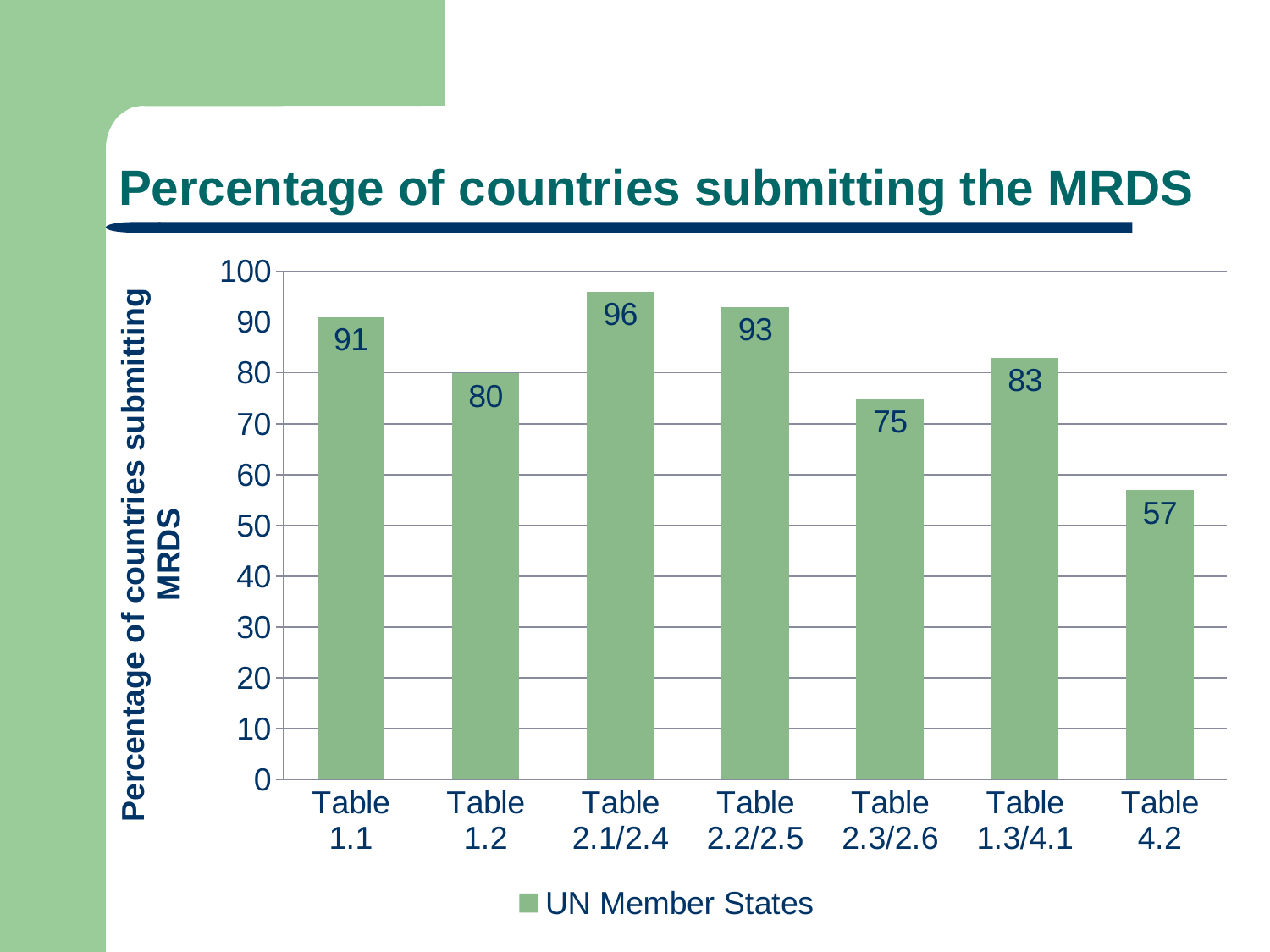
How many categories are shown on the x axis? 7 What is the difference between the values for Table 2.1/2.4 and Table 4.2? 39 Which category has the highest value? Table 2.1/2.4 What is the value for Table 1.1? 91 Which category has the lowest value? Table 4.2 Which is larger, the value for Table 2.2/2.5 or the value for Table 1.3/4.1? Table 2.2/2.5 What is the value for Table 4.2? 57 What is the difference between the values for Table 1.1 and Table 1.2? 11 What is the value for Table 2.3/2.6? 75 How many series does the legend list? 1 What is the legend entry for the series? UN Member States What kind of chart is shown on the slide? bar chart